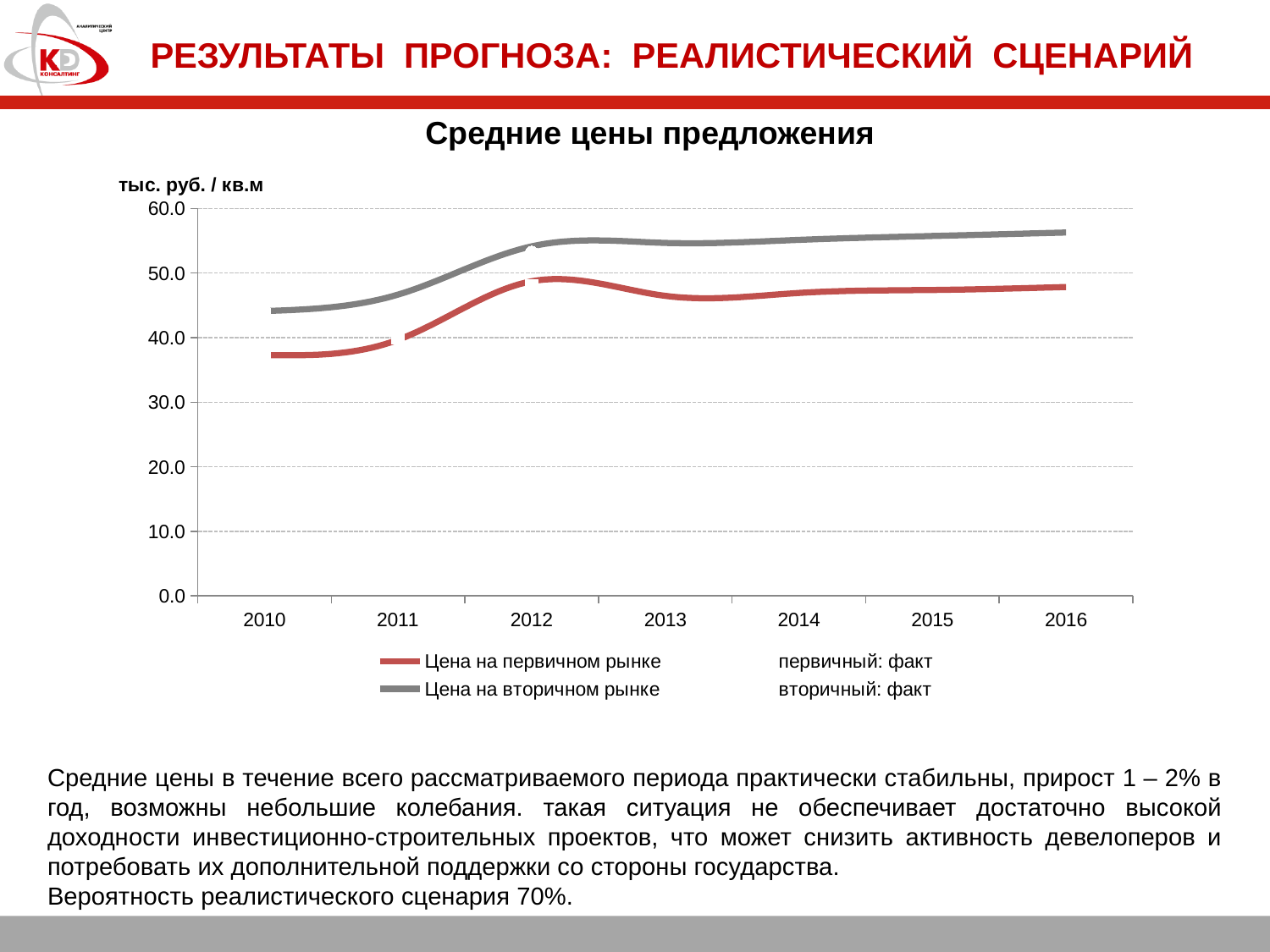
How many years are labelled on the x axis of the chart? 7 Is the value for Цена на первичном рынке in 2014 greater or less than 50.0? less What kind of chart is shown on the slide? line chart Does the Цена на вторичном рынке line rise or fall between 2010 and 2012? rise What unit is shown above the vertical axis of the chart? тыс. руб. / кв.м Is the value for Цена на первичном рынке in 2010 greater or less than 40.0? less In 2016, which is larger: Цена на первичном рынке or Цена на вторичном рынке? Цена на вторичном рынке What is the title of the chart? Средние цены предложения How many entries does the chart legend list? 4 Which series is drawn in red on the chart? Цена на первичном рынке Is the value for Цена на вторичном рынке in 2010 greater or less than 40.0? greater